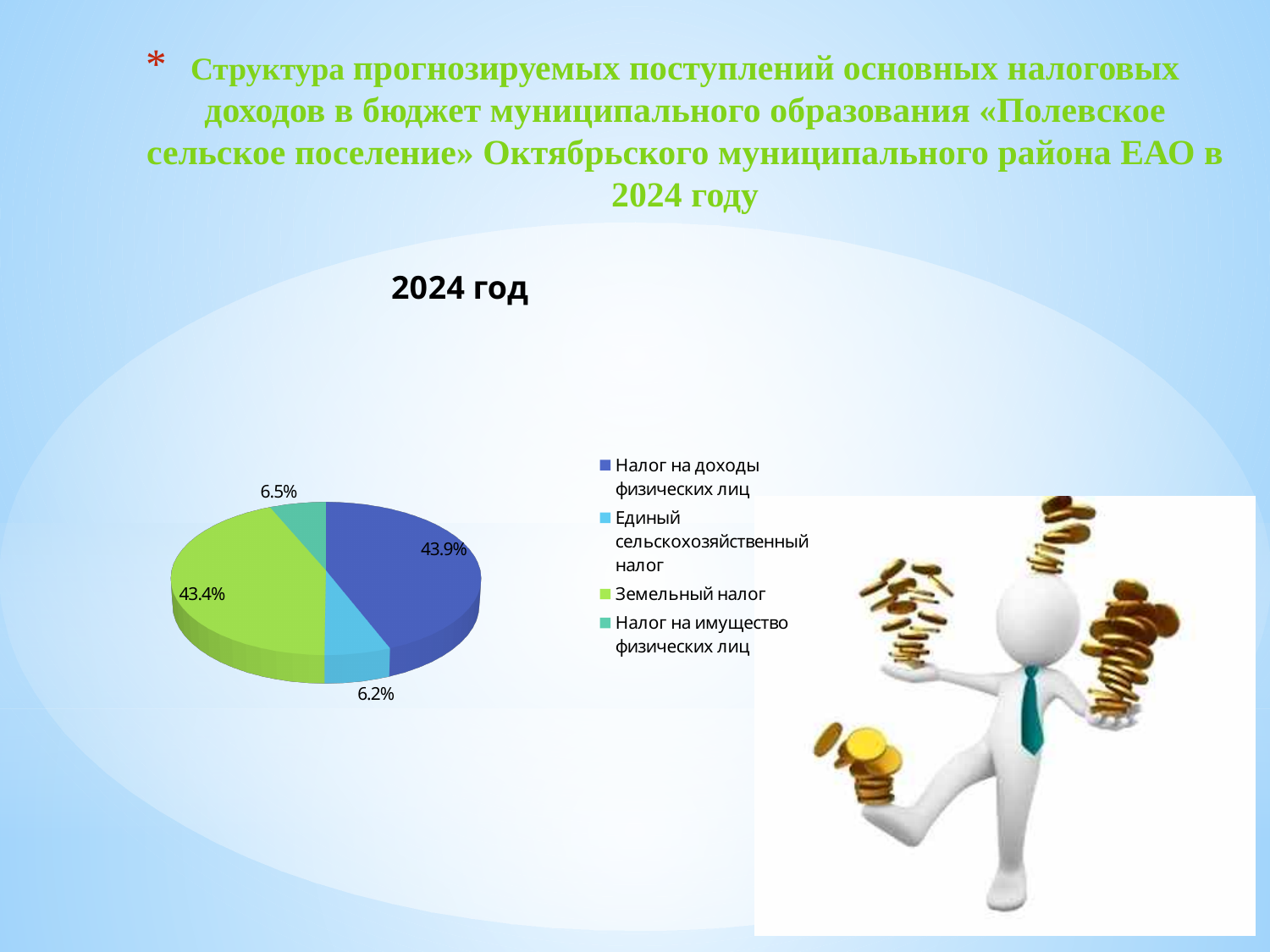
What share of the pie is Налог на имущество физических лиц? 6.5% What is the difference between the shares of Налог на доходы физических лиц and Земельный налог? 0.5% How many slices does the pie chart have? 4 What share of the pie is Единый сельскохозяйственный налог? 6.2% Which category has the smallest share of the pie? Единый сельскохозяйственный налог What is the title of the chart? 2024 год What share of the pie is Налог на доходы физических лиц? 43.9% How many entries does the legend list? 4 What share of the pie is Земельный налог? 43.4% Which category has the largest share of the pie? Налог на доходы физических лиц Which is larger: the share of Налог на имущество физических лиц or Единый сельскохозяйственный налог? Налог на имущество физических лиц What kind of chart is shown on the slide? pie chart